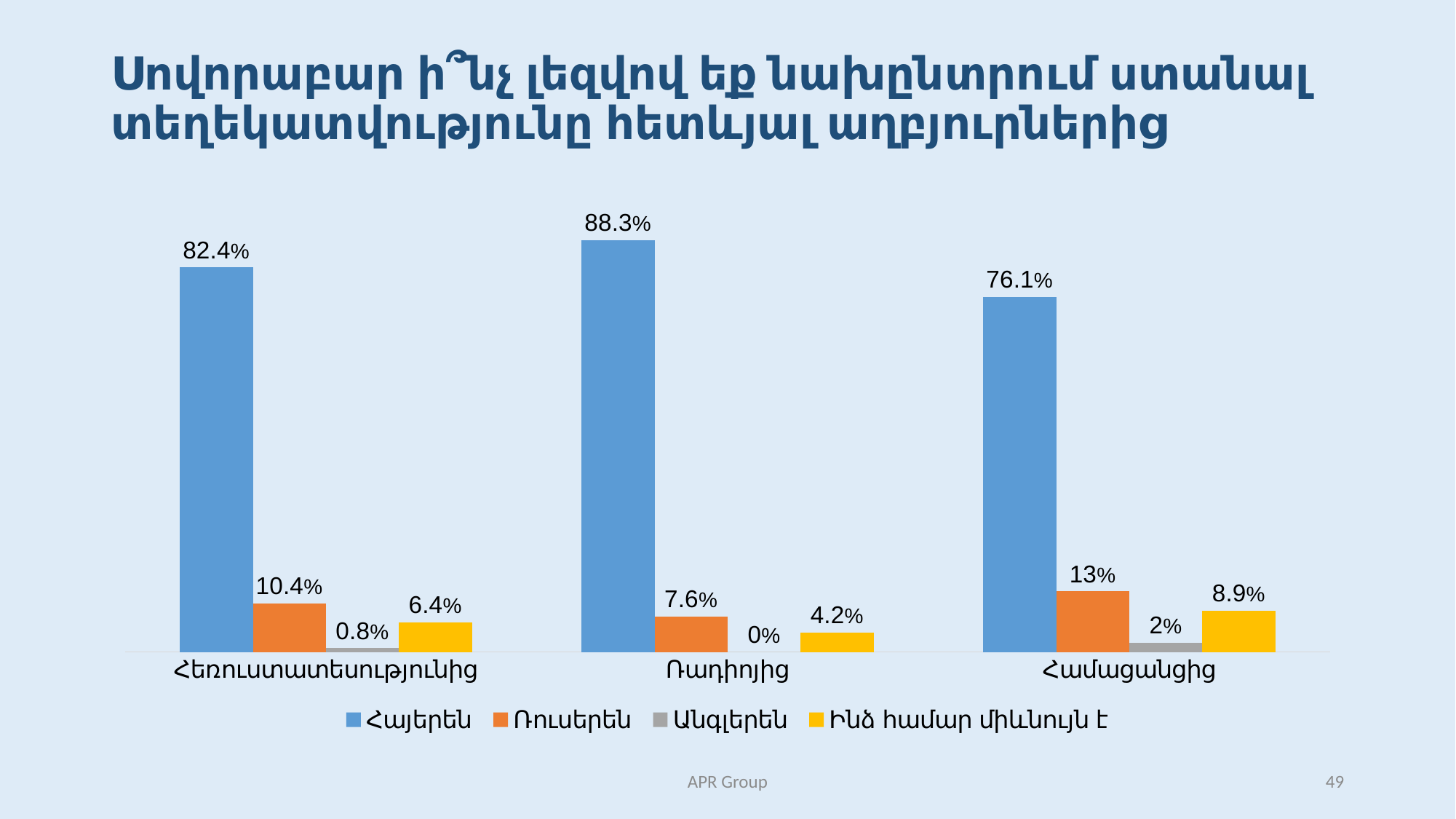
Which category has the highest value for Հայերեն? Ռադիոյից Which category has the lowest value for Անգլերեն? Ռադիոյից Which is larger: the Ռուսերեն value for Հեռուստատեսությունից or for Համացանցից? Համացանցից What is the value for Ինձ համար միևնույն է in the Ռադիոյից category? 4.2% What is the value for Հայերեն in the Ռադիոյից category? 88.3% Which colour represents the Ինձ համար միևնույն է series? Yellow What is the difference between the Հայերեն values for Ռադիոյից and Համացանցից? 12.2% What kind of chart is shown on the slide? Bar chart How many categories are shown on the x axis? 3 What is the value for Ռուսերեն in the Համացանցից category? 13% What is the value for Անգլերեն in the Հեռուստատեսությունից category? 0.8% How many series does the legend list? 4